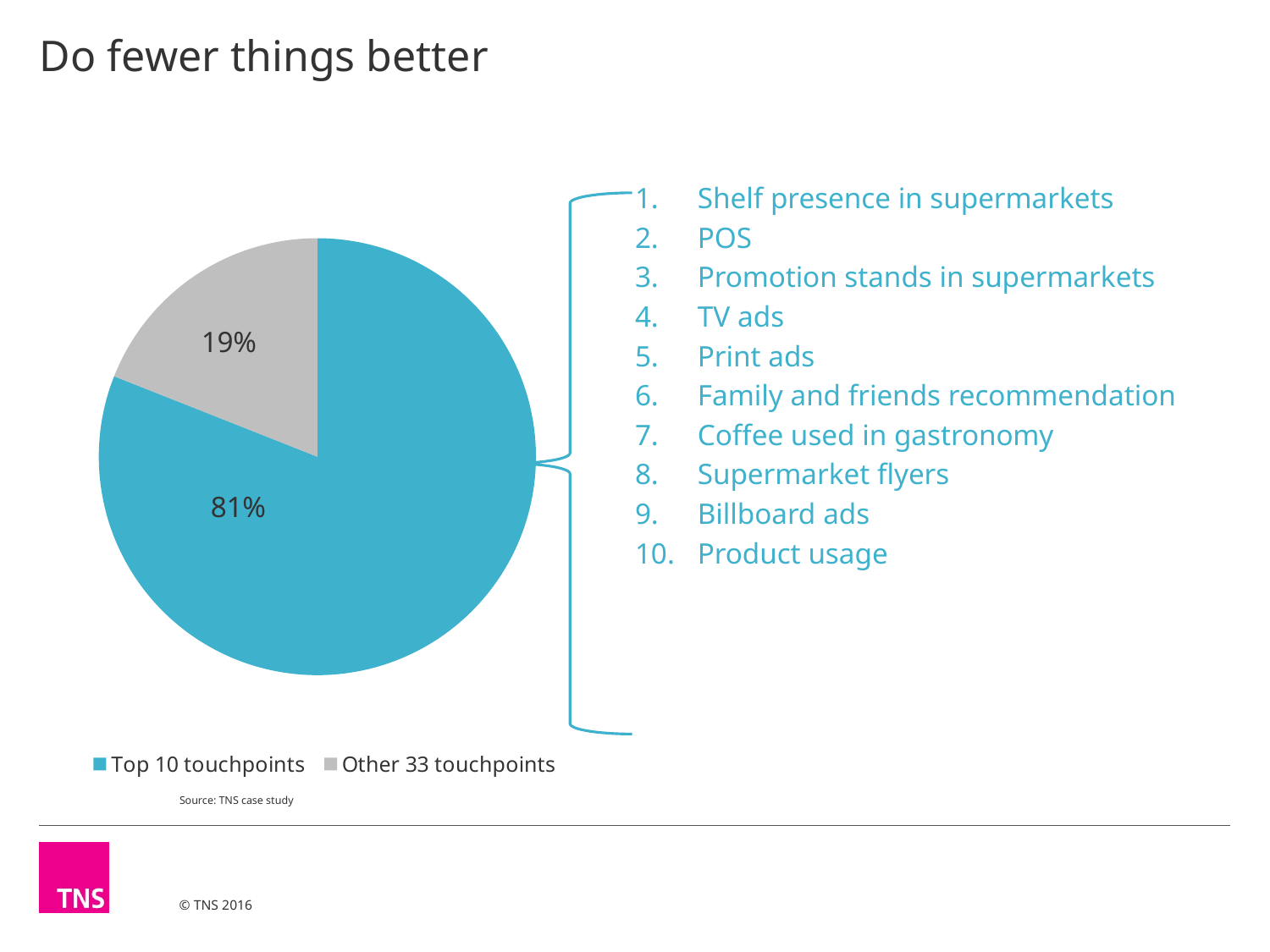
What colour is the Top 10 touchpoints slice? Blue What colour is the Other 33 touchpoints slice? Grey Which slice of the pie is the largest? Top 10 touchpoints What kind of chart is shown on the slide? Pie chart How many entries does the legend list? 2 What is the difference in percentage points between the Top 10 touchpoints slice and the Other 33 touchpoints slice? 62 Which is larger, the Top 10 touchpoints slice or the Other 33 touchpoints slice? Top 10 touchpoints What is the total of the two pie slice percentages? 100% What share of the pie is labelled for Other 33 touchpoints? 19% What share of the pie is labelled for Top 10 touchpoints? 81% Which slice of the pie is the smallest? Other 33 touchpoints How many slices does the pie chart have? 2